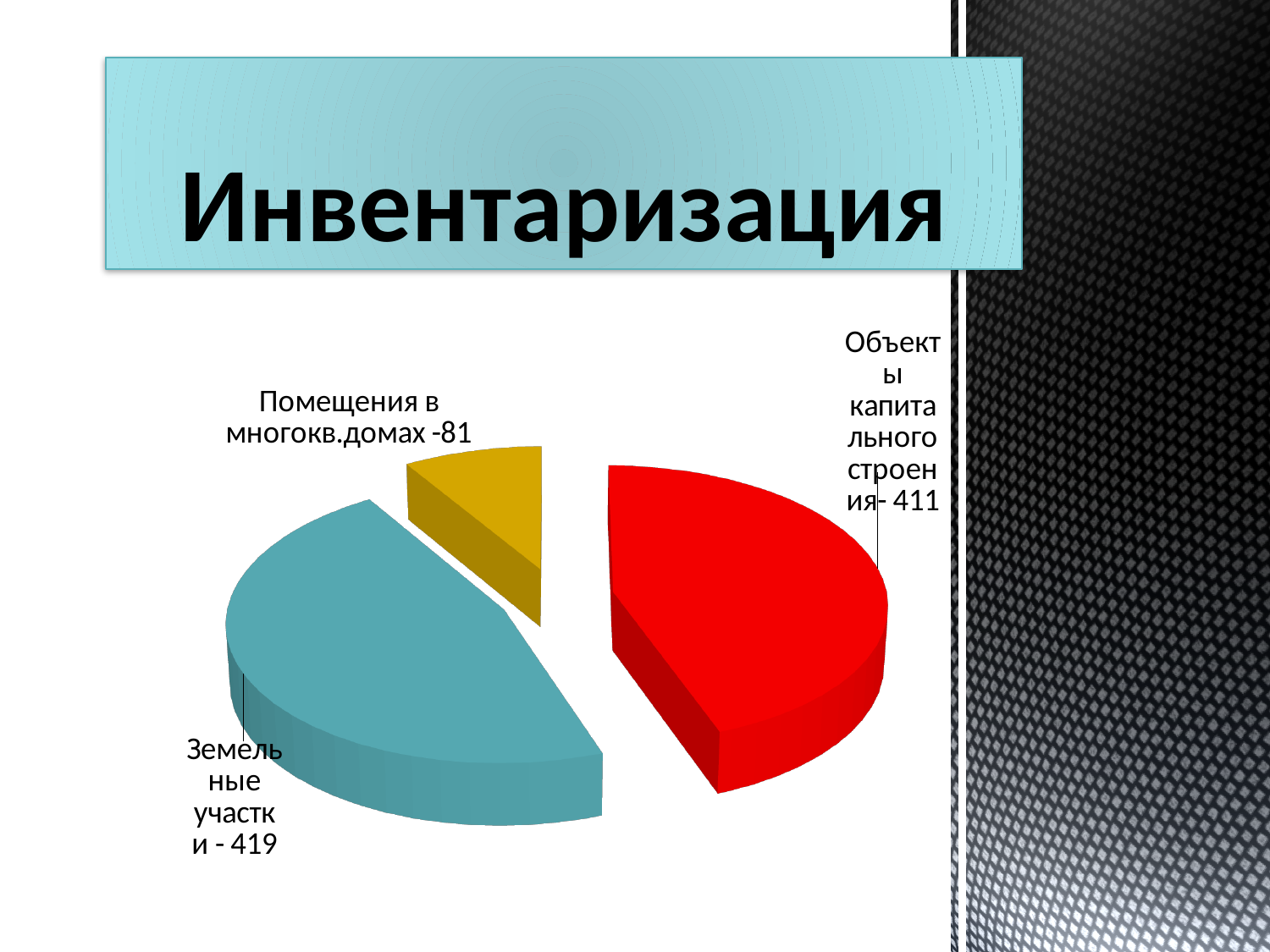
What is the difference between the values for Объекты капитального строения and Помещения в многокв.домах? 330 What is the total of all three slices in the pie chart? 911 Which category has the smallest value in the pie chart? Помещения в многокв.домах What is the difference between the values for Земельные участки and Объекты капитального строения? 8 Which is larger: the value for Объекты капитального строения or the value for Помещения в многокв.домах? Объекты капитального строения What is the value for Объекты капитального строения? 411 What is the value for Земельные участки? 419 Which category has the largest value in the pie chart? Земельные участки What kind of chart is shown on the slide? Pie chart How many slices does the pie chart have? 3 What is the title of the slide containing the pie chart? Инвентаризация What is the value for Помещения в многокв.домах? 81